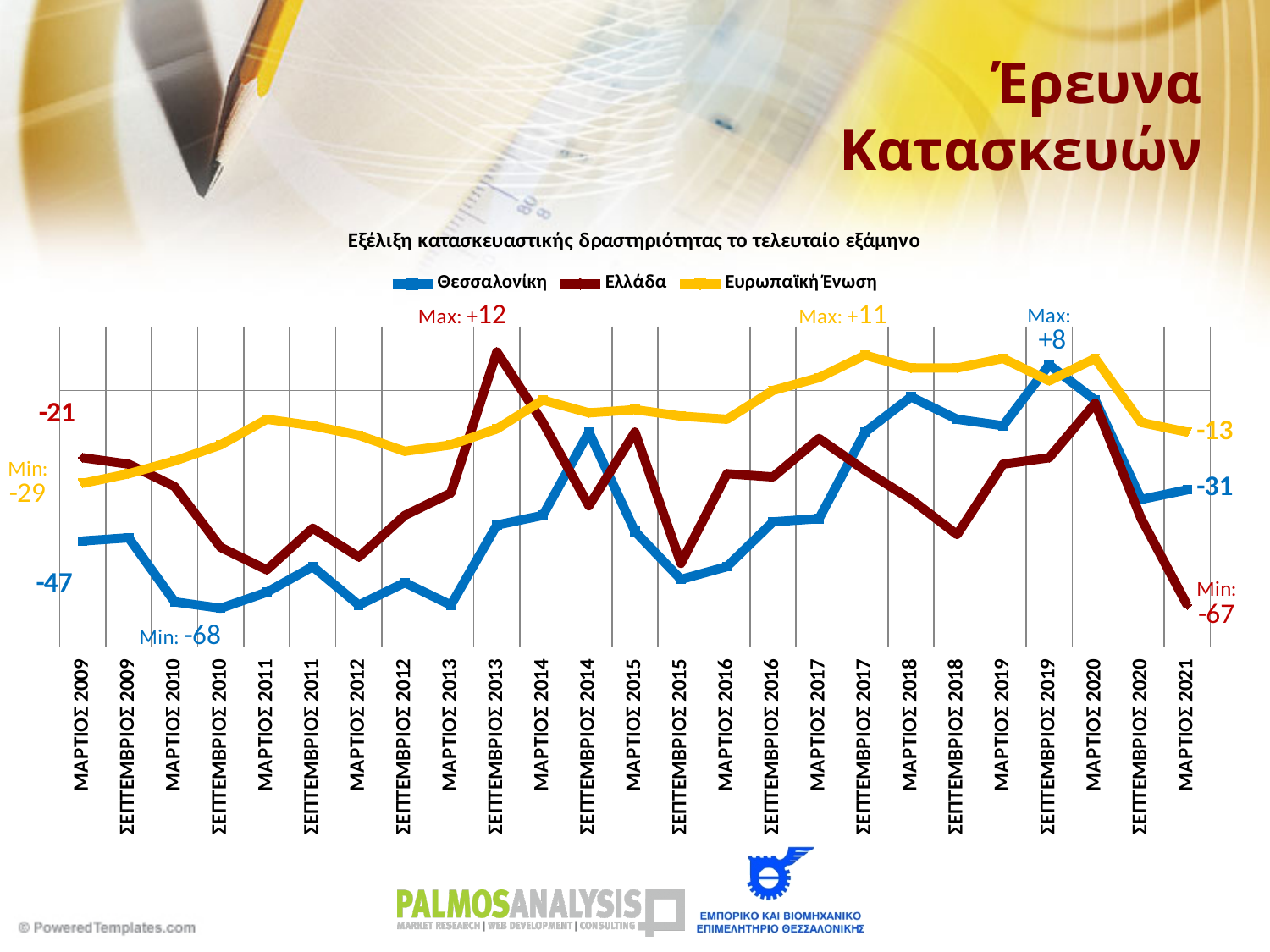
What is the value for Θεσσαλονίκη in ΜΑΡΤΙΟΣ 2021? -31 How many time periods are shown on the x axis of the chart? 25 By how much did the Ελλάδα value fall from ΜΑΡΤΙΟΣ 2009 (-21) to ΜΑΡΤΙΟΣ 2021 (-67)? 46 In which period does the Ελλάδα series reach its maximum, and what is that value? ΣΕΠΤΕΜΒΡΙΟΣ 2013, +12 What type of chart is shown on the slide? Line chart In ΜΑΡΤΙΟΣ 2021, which series has the higher value: Ευρωπαϊκή Ένωση or Θεσσαλονίκη? Ευρωπαϊκή Ένωση How many series does the chart legend list? 3 What is the maximum value of the Ευρωπαϊκή Ένωση series? +11 What is the value for Θεσσαλονίκη in ΜΑΡΤΙΟΣ 2009? -47 What is the value for Ευρωπαϊκή Ένωση in ΜΑΡΤΙΟΣ 2021? -13 What is the value for Ελλάδα in ΜΑΡΤΙΟΣ 2021? -67 In which period does the Θεσσαλονίκη series reach its minimum, and what is that value? ΣΕΠΤΕΜΒΡΙΟΣ 2010, -68